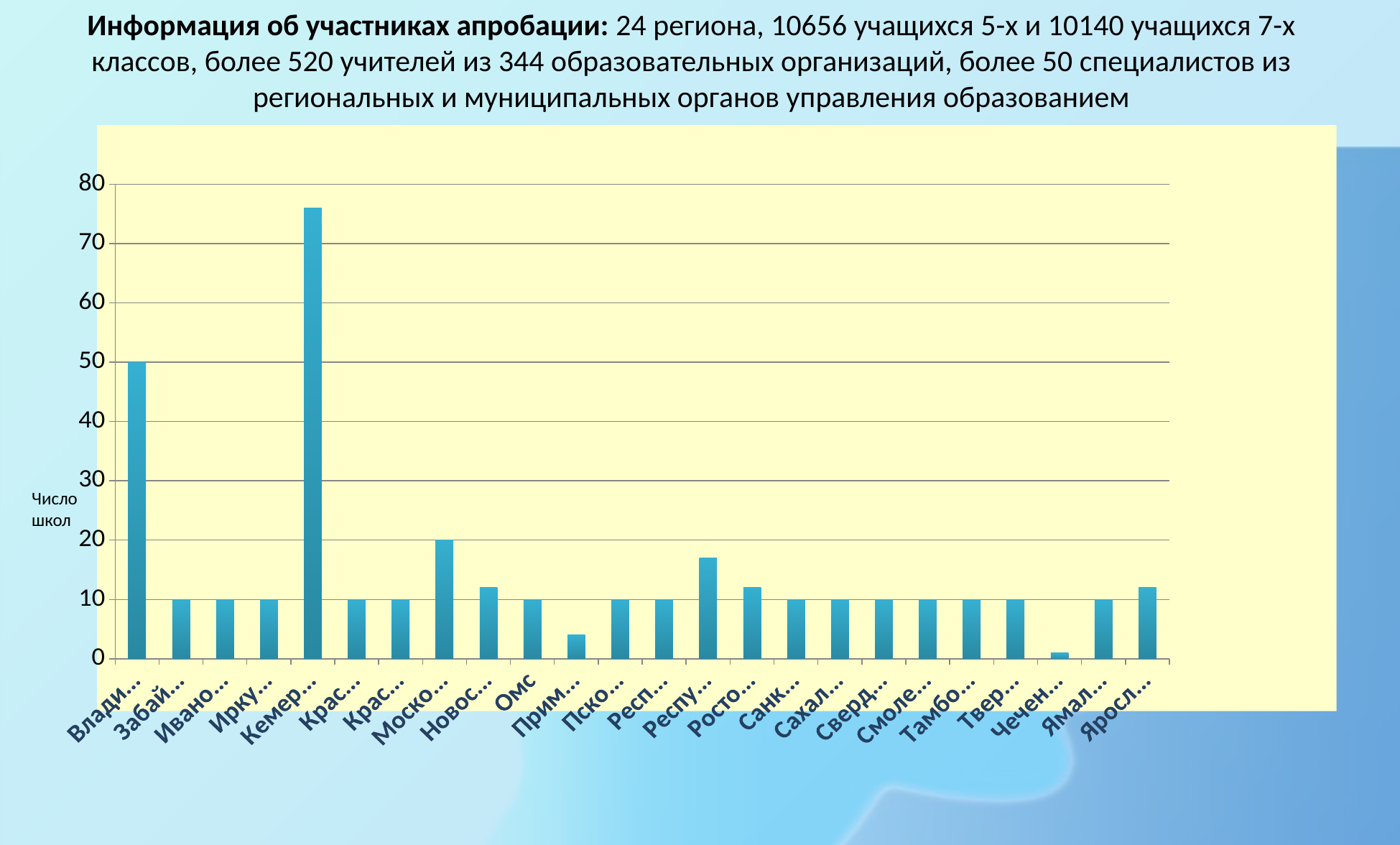
What is the value for the first bar, Влади…? 50 Which region has the lowest number of schools in the chart? Чечен… Is the value for Прим… greater or less than 10? less Is the value for Кемер… greater or less than 70? greater What is the value for Забай…? 10 Is the value for Респу… greater or less than 20? less What kind of chart is shown on the slide? bar chart What is the value for Моско…? 20 Which is larger, the value for Влади… or the value for Моско…? Влади… How many bars (regions) are plotted in the chart? 24 What is the label on the vertical axis of the chart? Число школ Which region has the highest number of schools in the chart? Кемер…